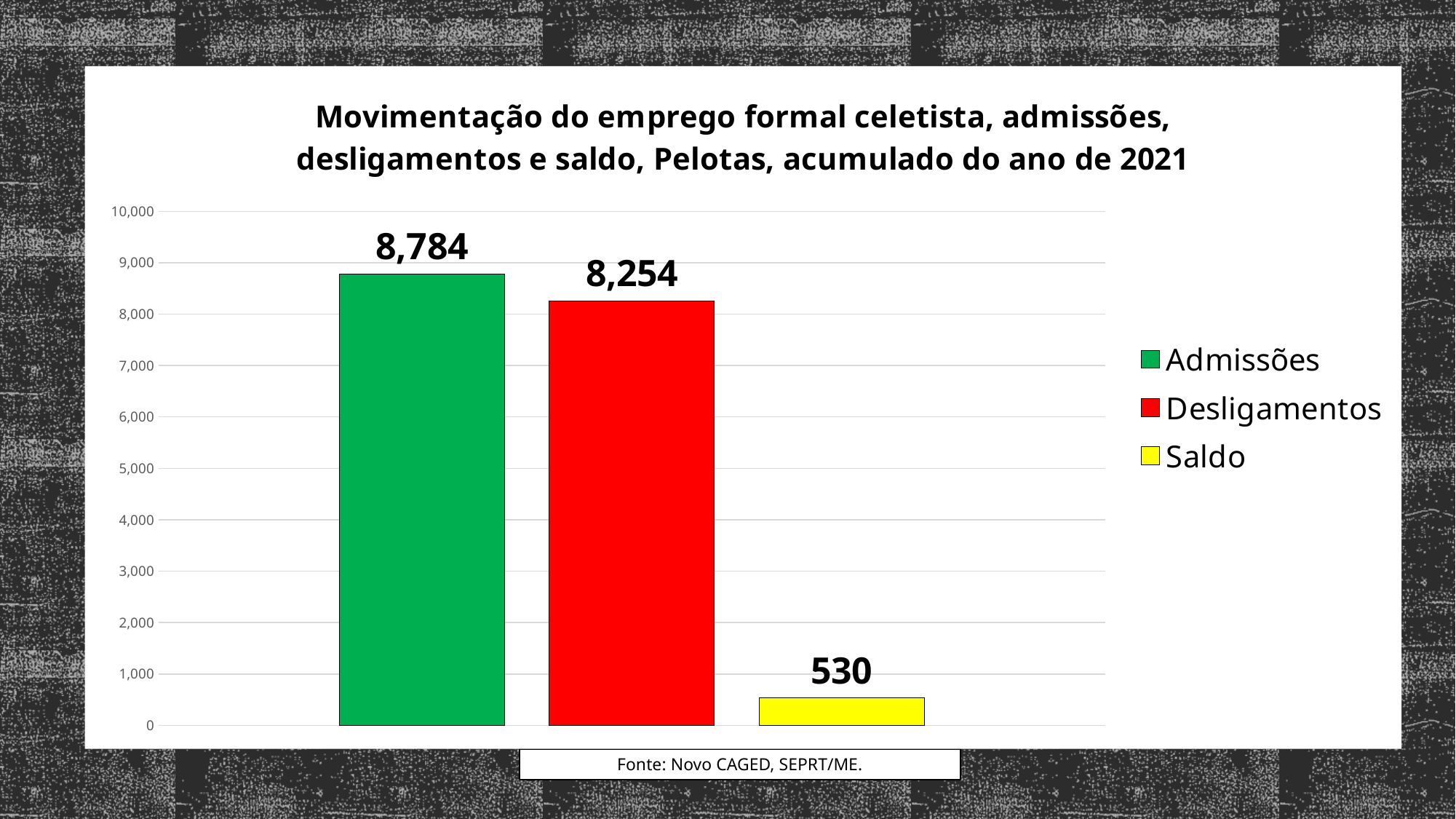
What kind of chart is shown? bar chart Is the value for Saldo greater or less than 1,000? less What colour is the bar for Saldo? yellow What is the value for Desligamentos? 8,254 Which is larger, Admissões or Desligamentos? Admissões What is the value for Saldo? 530 Which series has the lowest value? Saldo Is the value for Desligamentos greater or less than 8,000? greater Which series has the highest value? Admissões What is the difference between Admissões and Desligamentos? 530 How many series does the legend list? 3 What is the value for Admissões? 8,784